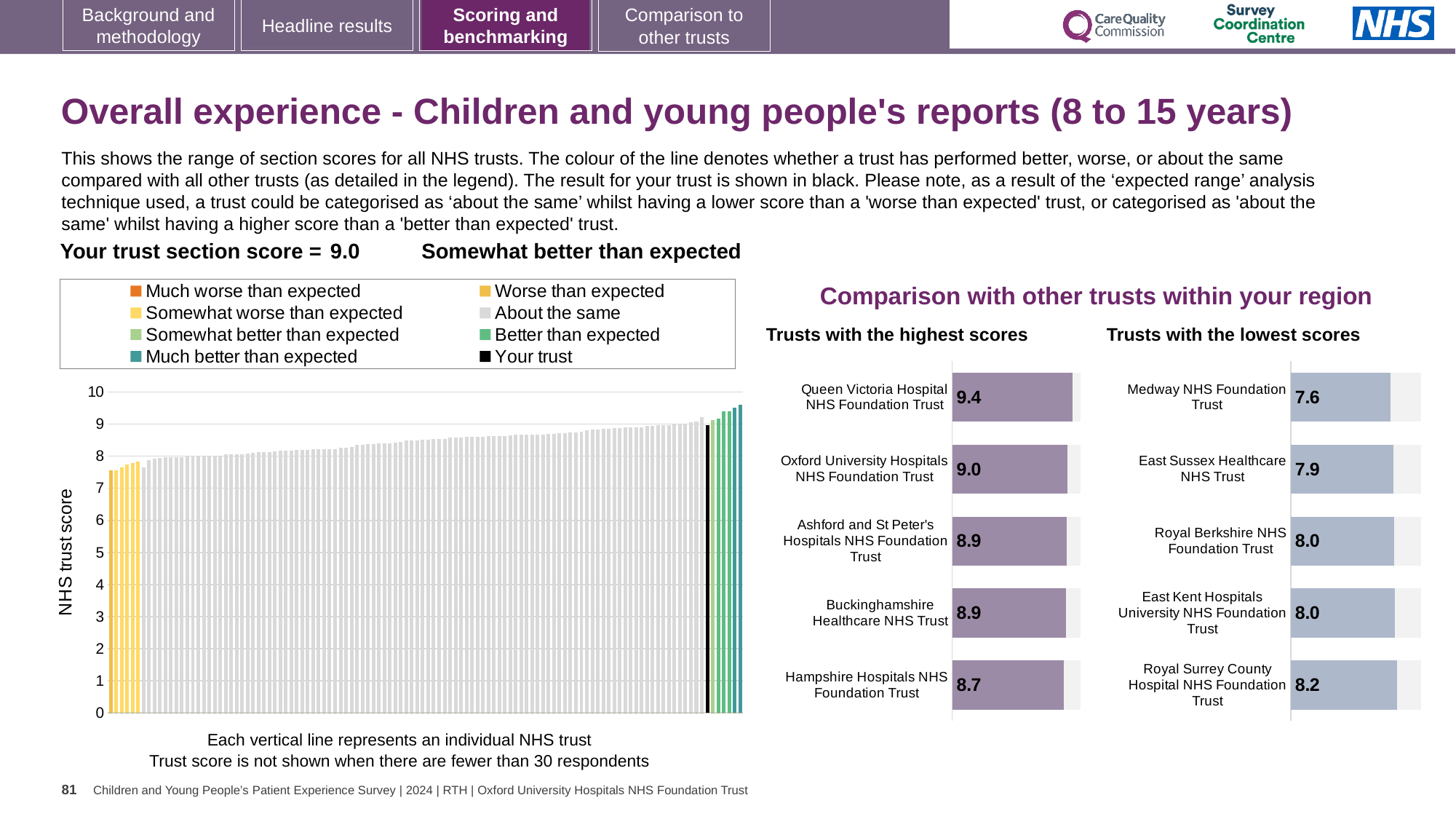
Which has a higher score: Oxford University Hospitals NHS Foundation Trust in the highest scores chart or East Sussex Healthcare NHS Trust in the lowest scores chart? Oxford University Hospitals NHS Foundation Trust How many trusts are shown in the 'Trusts with the lowest scores' chart? 5 In the 'Trusts with the highest scores' chart, which trust has the highest score? Queen Victoria Hospital NHS Foundation Trust In the 'Trusts with the lowest scores' chart, what is the score for Medway NHS Foundation Trust? 7.6 In the 'Trusts with the lowest scores' chart, what is the score for Royal Surrey County Hospital NHS Foundation Trust? 8.2 In the 'Trusts with the highest scores' chart, what is the difference between the scores of Queen Victoria Hospital NHS Foundation Trust and Hampshire Hospitals NHS Foundation Trust? 0.7 How many entries does the legend of the large chart on the left list? 8 In the 'Trusts with the lowest scores' chart, which trust has the lowest score? Medway NHS Foundation Trust In the 'Trusts with the lowest scores' chart, what is the difference between the scores of Royal Surrey County Hospital NHS Foundation Trust and Medway NHS Foundation Trust? 0.6 In the 'Trusts with the highest scores' chart, what is the score for Queen Victoria Hospital NHS Foundation Trust? 9.4 In the 'Trusts with the highest scores' chart, what is the score for Hampshire Hospitals NHS Foundation Trust? 8.7 In the large chart on the left showing all NHS trusts, do the scores rise or fall from left to right? rise